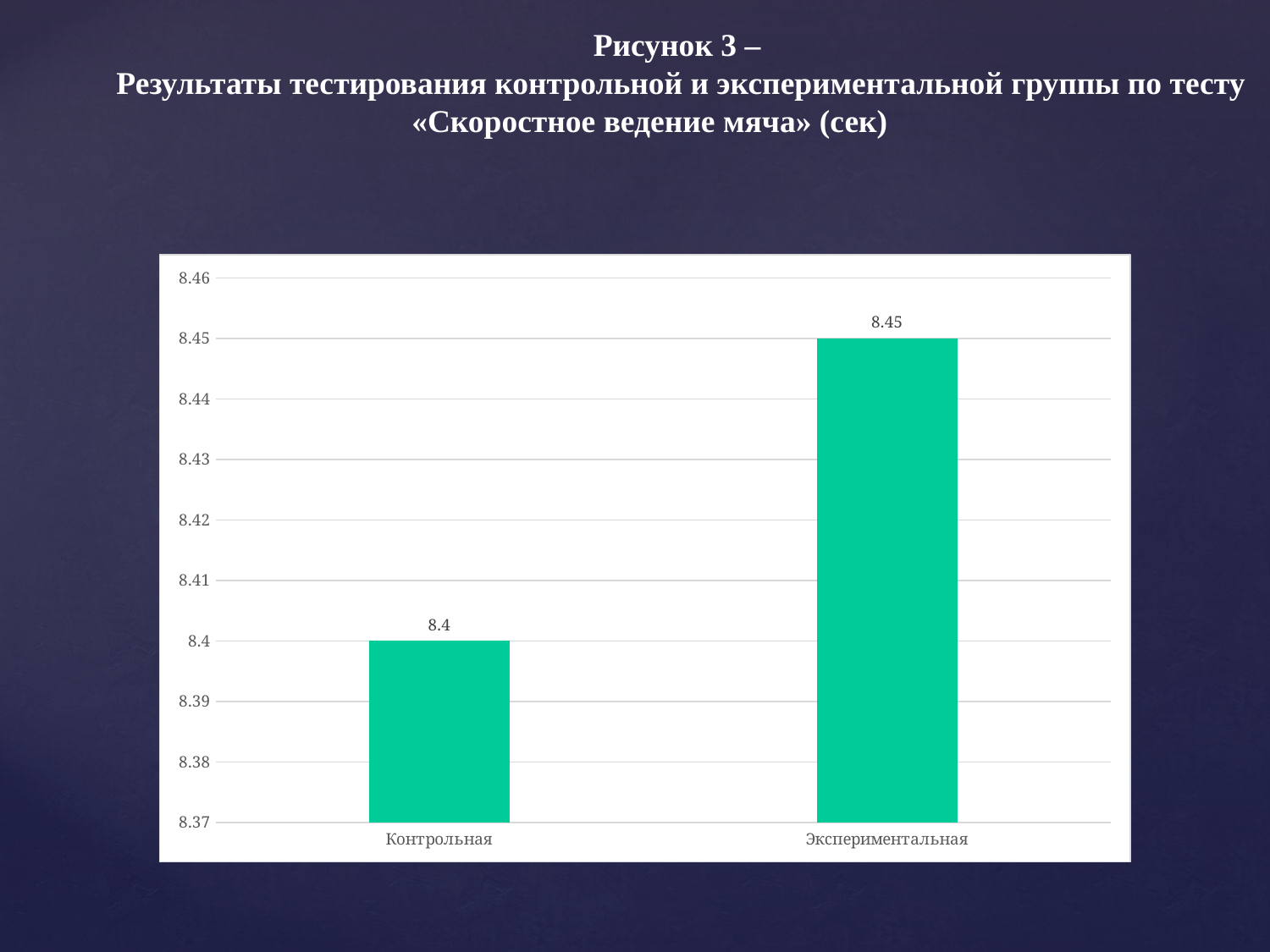
What is the difference between the values for Экспериментальная and Контрольная? 0.05 What is the lowest value shown on the vertical axis? 8.37 What kind of chart is shown on the slide? bar chart What is the value for Экспериментальная? 8.45 Which is larger, the value for Контрольная or the value for Экспериментальная? Экспериментальная Is the value for Экспериментальная greater or less than 8.42? greater What is the value for Контрольная? 8.4 Which group has the lowest value? Контрольная What unit is given in the slide title for the test results? сек Is the value for Контрольная greater or less than 8.43? less How many categories are shown on the chart? 2 Which group has the highest value? Экспериментальная